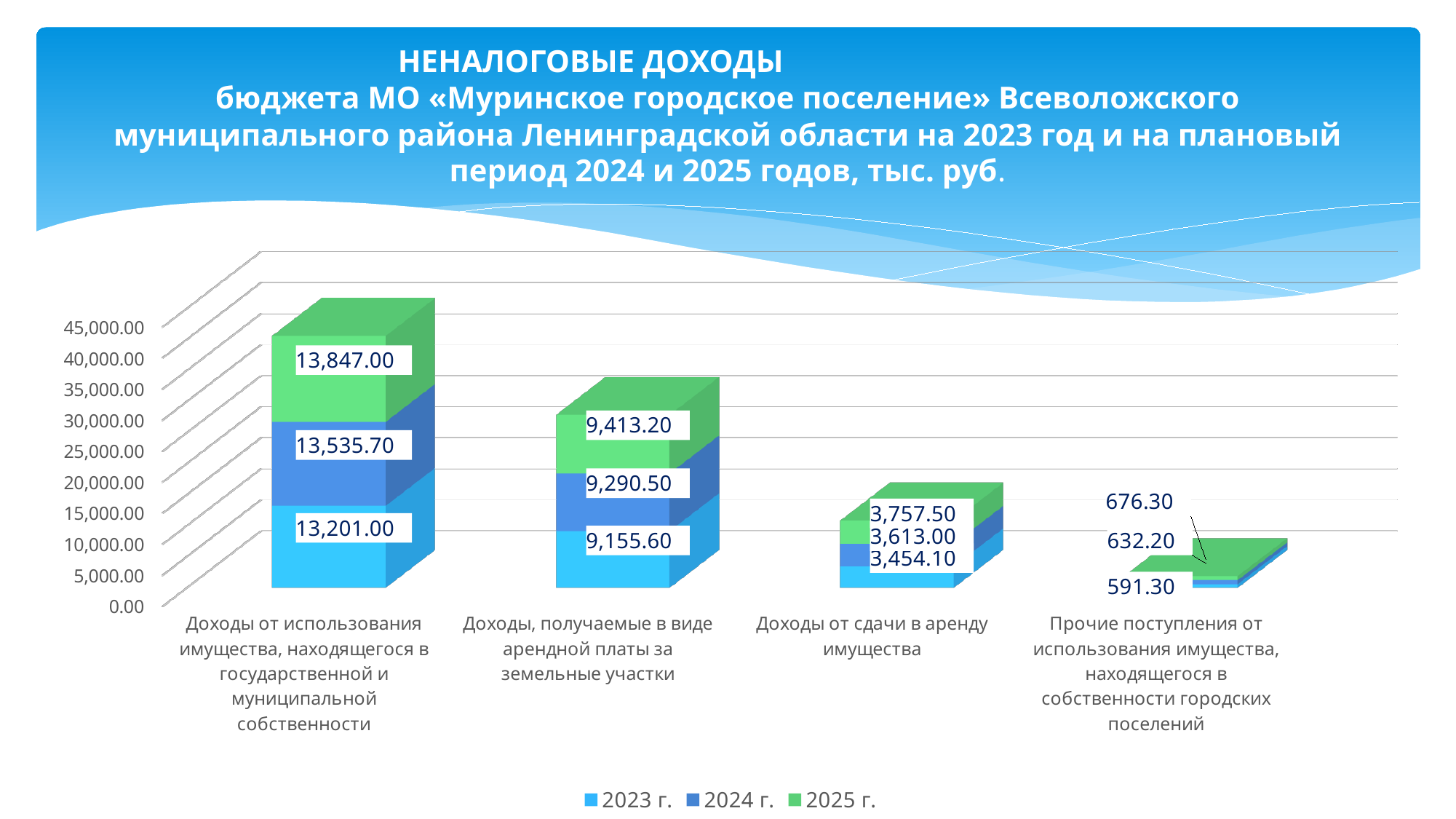
Which is larger for «Доходы, получаемые в виде арендной платы за земельные участки»: the 2024 г. value or the 2023 г. value? 2024 г. How many series does the legend list? 3 What is the 2023 г. value for «Доходы от сдачи в аренду имущества»? 3,454.10 What is the 2025 г. value for «Доходы, получаемые в виде арендной платы за земельные участки»? 9,413.20 What is the 2024 г. value for «Прочие поступления от использования имущества, находящегося в собственности городских поселений»? 632.20 Which category has the highest total stacked value? Доходы от использования имущества, находящегося в государственной и муниципальной собственности What type of chart is shown on the slide? Stacked bar chart How many categories are shown on the x axis? 4 Which category has the lowest total stacked value? Прочие поступления от использования имущества, находящегося в собственности городских поселений What is the difference between the 2025 г. and 2023 г. values for «Доходы от использования имущества, находящегося в государственной и муниципальной собственности»? 646.00 What is the total of the stacked bar for «Доходы от сдачи в аренду имущества»? 10,824.60 Do the values for «Прочие поступления от использования имущества, находящегося в собственности городских поселений» rise or fall from 2023 г. to 2025 г.? Rise